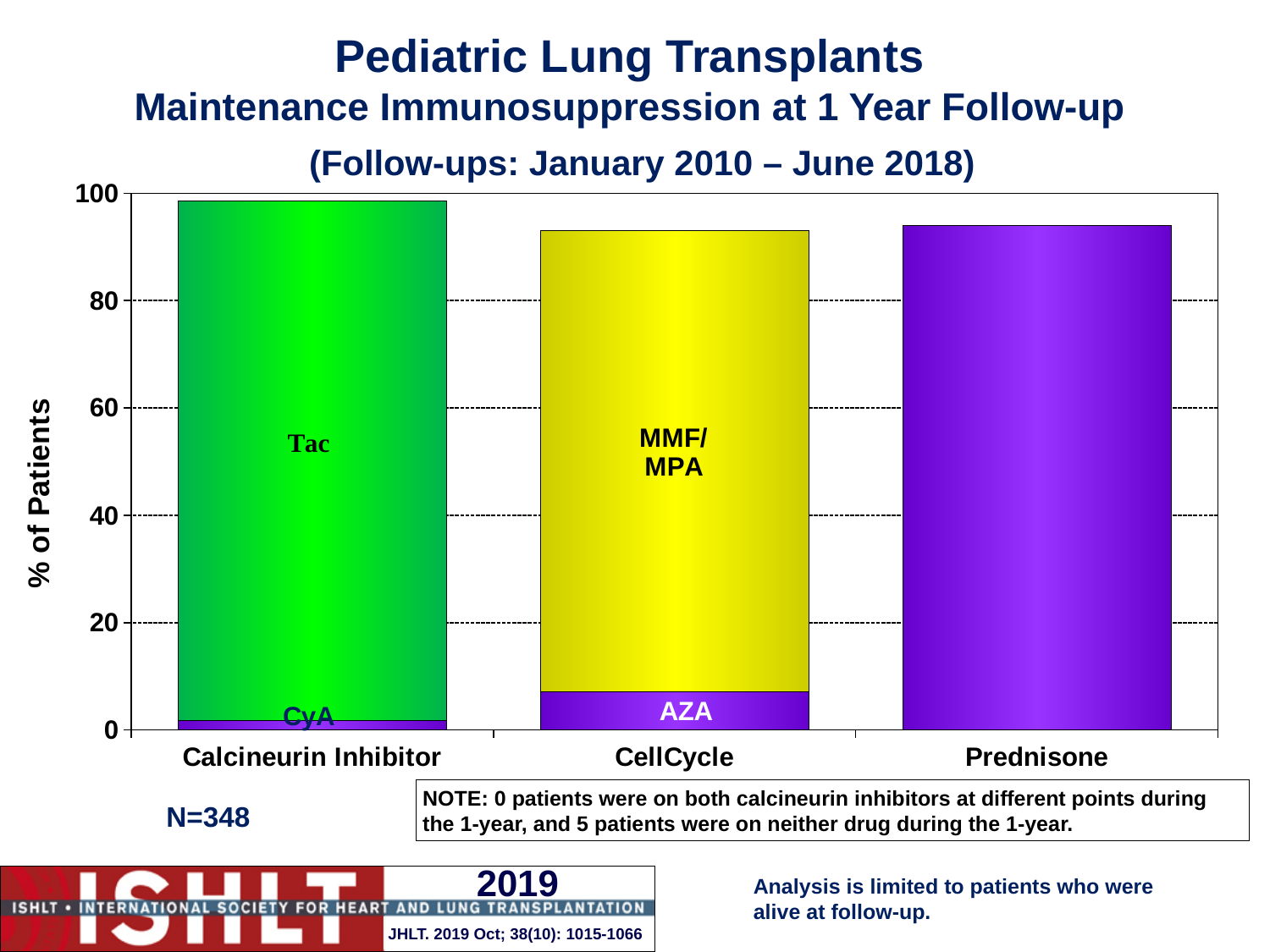
Within the CellCycle bar, which segment is larger, MMF/MPA or AZA? MMF/MPA What is the label on the y axis of the chart? % of Patients Is the value of the AZA segment in the CellCycle bar greater or less than 20? less Which category has the tallest bar overall? Calcineurin Inhibitor What is the sample size (N) shown below the chart? N=348 Is the total value of the CellCycle bar greater or less than 60? greater Is the value for Prednisone greater or less than 80? greater How many categories are shown on the x axis of the chart? 3 What kind of chart is shown on the slide? Stacked bar chart Within the Calcineurin Inhibitor bar, which segment is larger, Tac or CyA? Tac